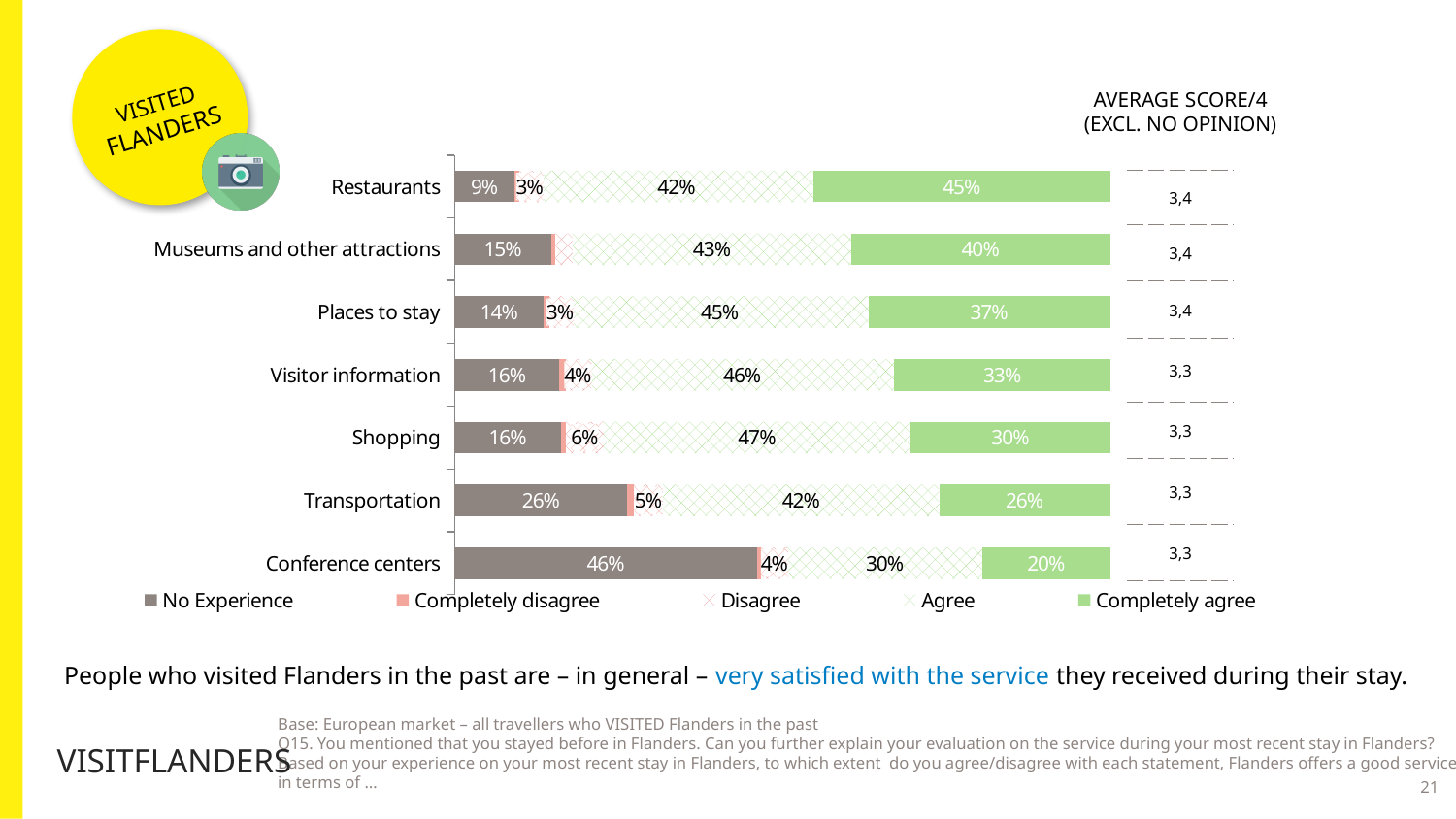
Which category has the highest 'Completely agree' percentage? Restaurants What type of chart is shown on the slide? Stacked bar chart Which has a larger 'No Experience' share, Transportation or Shopping? Transportation What is the average score (out of 4) shown for Visitor information? 3,3 What is the difference between the 'Completely agree' percentages for Restaurants and Conference centers? 25% What is the title of the column of values shown to the right of the bars? AVERAGE SCORE/4 (EXCL. NO OPINION) What is the 'Completely agree' percentage for Restaurants? 45% How many series does the legend list? 5 How many categories (service areas) are plotted in the chart? 7 What is the 'No Experience' percentage for Conference centers? 46% Which category has the highest 'No Experience' percentage? Conference centers Which category has the lowest 'Completely agree' percentage? Conference centers